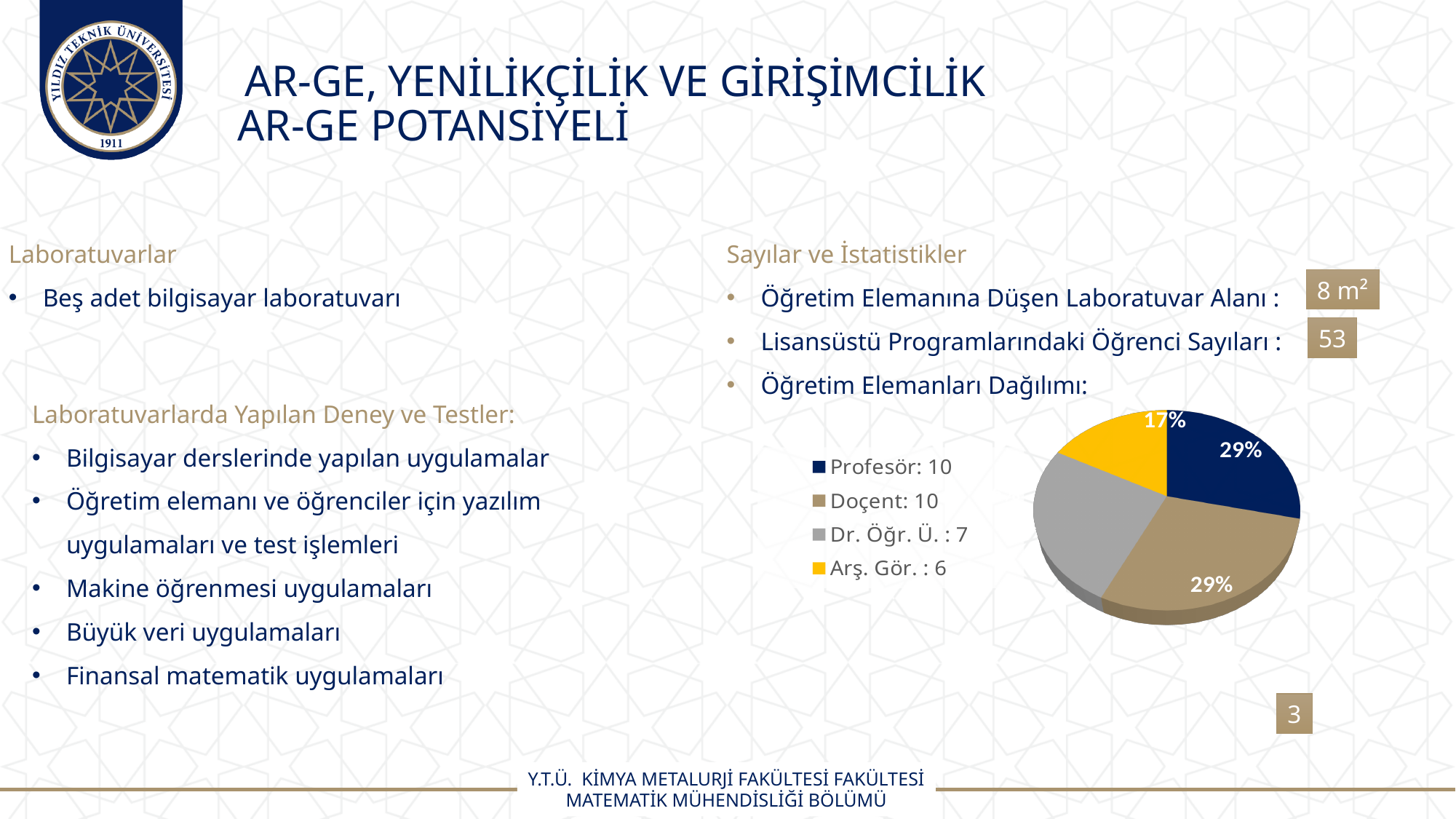
How many categories does the pie chart's legend list? 4 What value does the legend give for Dr. Öğr. Ü.? 7 What is the difference between the value for Profesör and the value for Arş. Gör.? 4 What percentage share is labelled on the Doçent slice of the pie chart? 29% Which is larger, the value for Dr. Öğr. Ü. or the value for Arş. Gör.? Dr. Öğr. Ü. Which category has the smallest value in the pie chart? Arş. Gör. What value does the legend give for Profesör? 10 What kind of chart is shown under "Öğretim Elemanları Dağılımı"? pie chart What value does the legend give for Doçent? 10 What colour is the Arş. Gör. slice in the pie chart? yellow What percentage share is labelled on the Profesör slice of the pie chart? 29% What value does the legend give for Arş. Gör.? 6